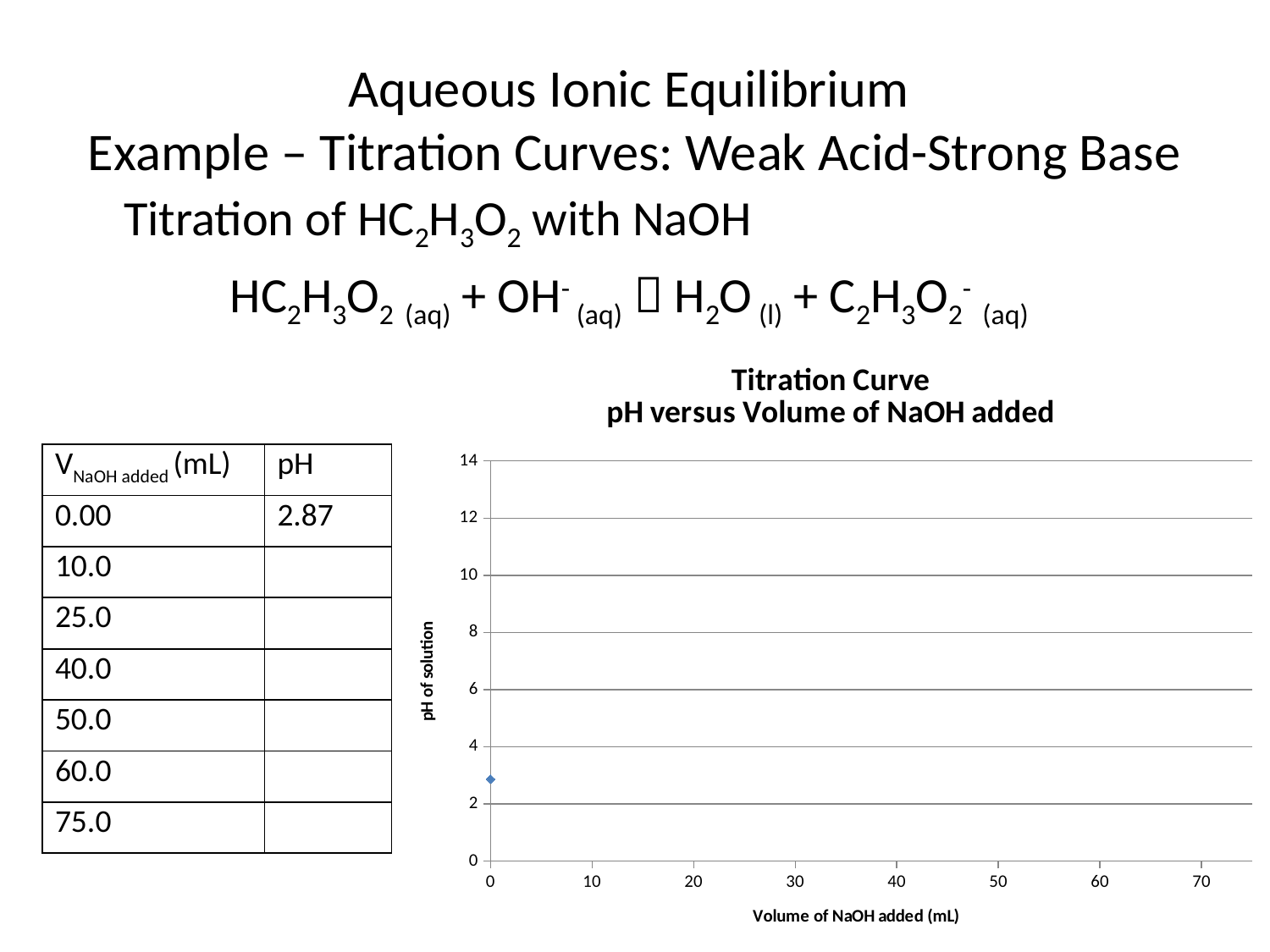
On the Titration Curve chart, is the pH value at 0 mL of NaOH added greater or less than 4? less What is the label of the vertical axis of the chart? pH of solution How many data points are plotted on the Titration Curve chart? 1 What is the pH of the solution when 0.00 mL of NaOH has been added, as plotted on the chart and listed in the table? 2.87 On the Titration Curve chart, is the pH value at 0 mL of NaOH added greater or less than 2? greater What kind of chart is shown on the slide? scatter chart What is the title of the chart on the slide? Titration Curve pH versus Volume of NaOH added